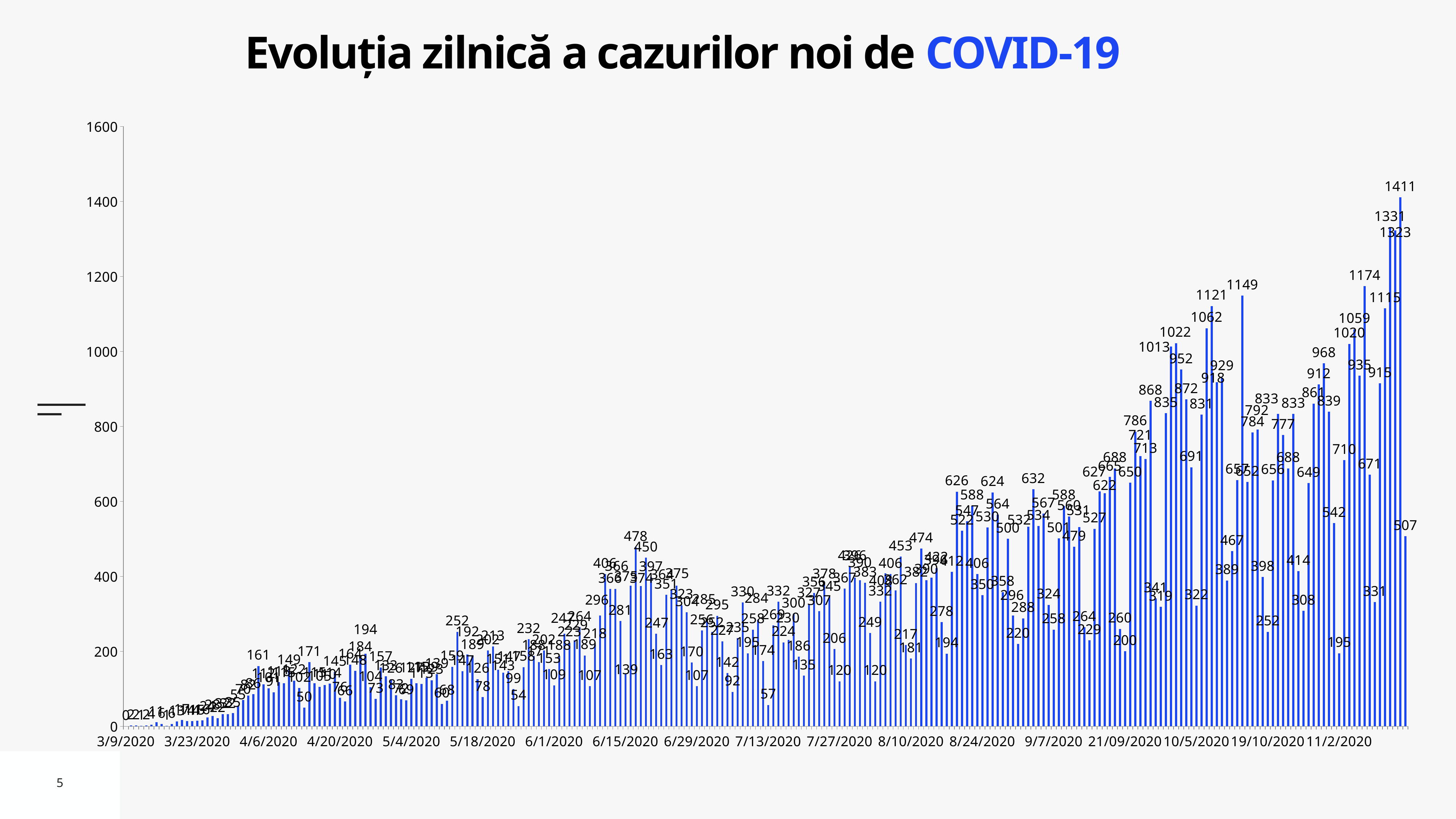
What is the highest value shown on the vertical axis? 1600 What is the difference between the tallest bar (1411) and the rightmost bar (507)? 904 Is the value of the tallest bar greater or less than 1400? greater What is the value labelled on the rightmost (final) bar of the chart? 507 Overall, do the daily values rise or fall from 3/9/2020 to the end of the chart? rise What kind of chart is shown on the slide? bar chart What is the value of the tallest bar in the chart? 1411 Is the value for the first bar at 3/9/2020 greater or less than 200? less What is the title of the chart? Evoluția zilnică a cazurilor noi de COVID-19 Which is larger, the tallest bar or the rightmost bar? the tallest bar (1411)